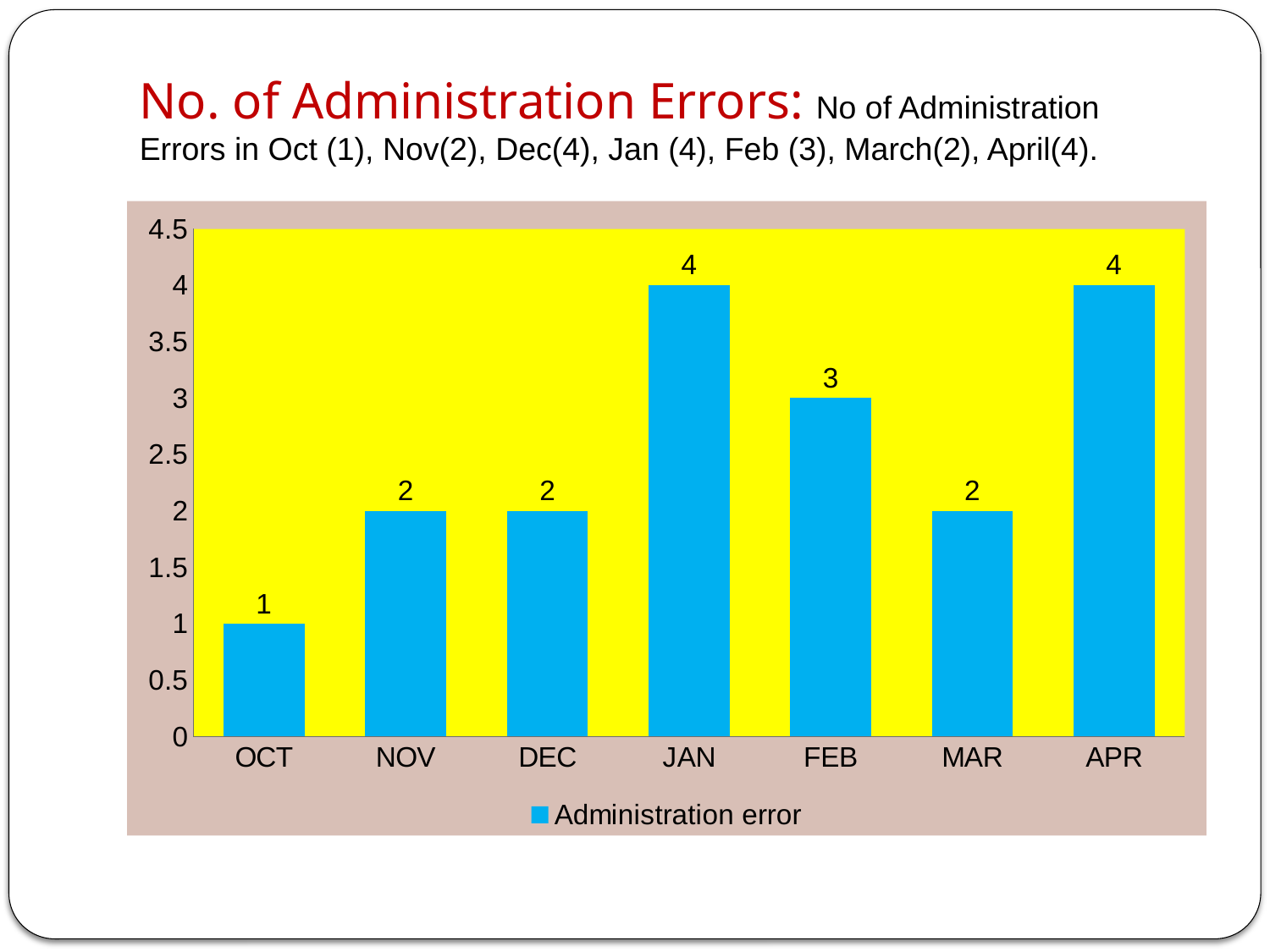
What is the value for DEC as plotted in the chart? 2 What is the value for FEB? 3 What is the value for OCT? 1 What is the legend entry for the series? Administration error Which month has the lowest value? OCT Which is larger, the value for FEB or the value for MAR? FEB Which months share the highest value? JAN and APR How many months are shown on the x axis? 7 What is the difference between the values for JAN and OCT? 3 How many series does the legend list? 1 What kind of chart is this? bar chart What is the value for JAN? 4